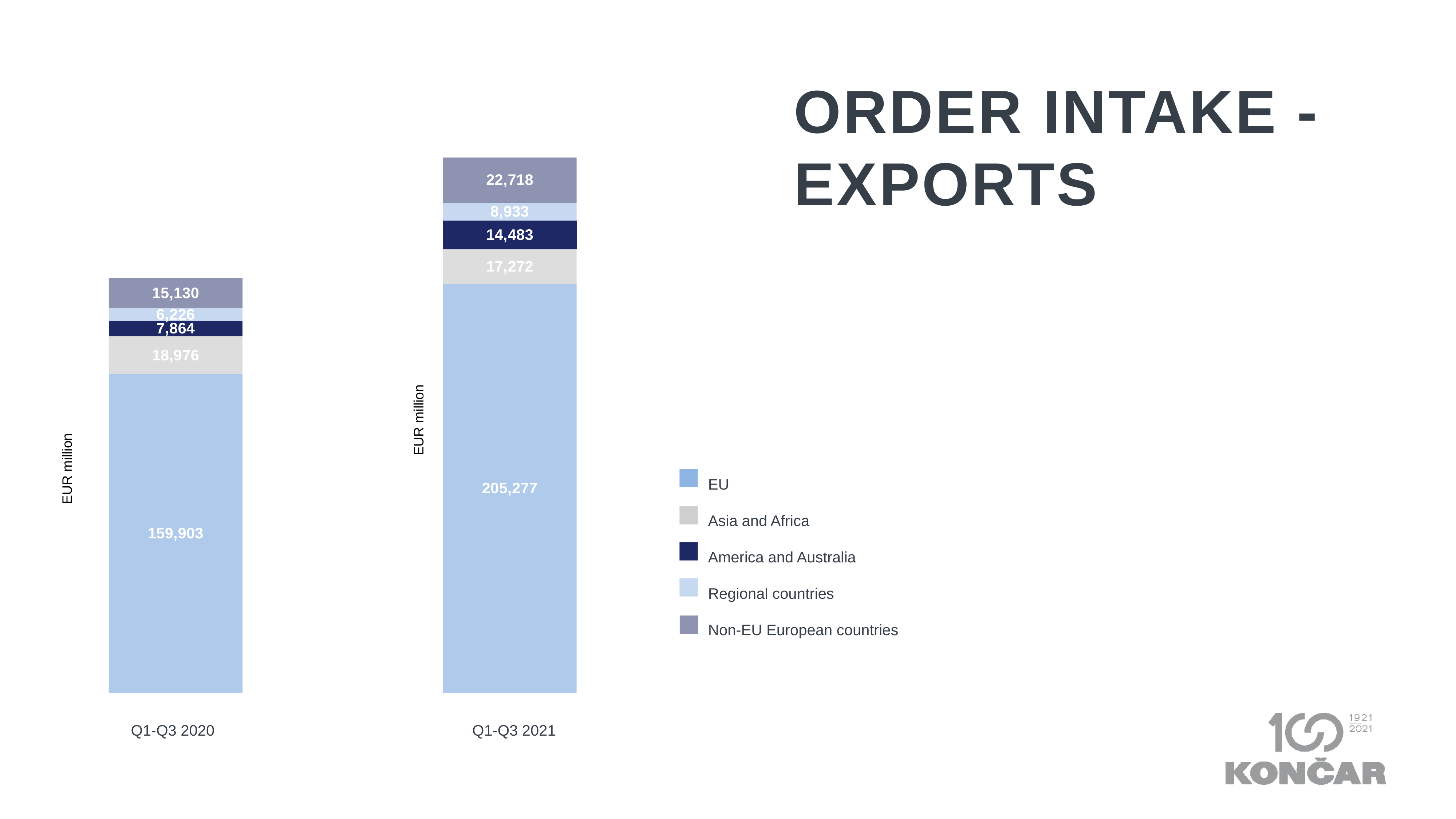
What is the value for Non-EU European countries in Q1-Q3 2021? 22,718 What is the difference between the America and Australia values for Q1-Q3 2021 and Q1-Q3 2020? 6,619 What is the value for Asia and Africa in the Q1-Q3 2020 bar? 18,976 What is the value for Regional countries in Q1-Q3 2020? 6,226 By how much did the EU value increase from Q1-Q3 2020 to Q1-Q3 2021? 45,374 Which region has the smallest segment in the Q1-Q3 2020 bar? Regional countries Which is larger: Asia and Africa in Q1-Q3 2020 or Asia and Africa in Q1-Q3 2021? Q1-Q3 2020 What is the total of the Q1-Q3 2020 stacked bar? 208,099 Which region has the largest segment in the Q1-Q3 2021 bar? EU What kind of chart is shown on the slide? Stacked bar chart How many series does the legend list? 5 What is the EU order intake value for Q1-Q3 2021? 205,277